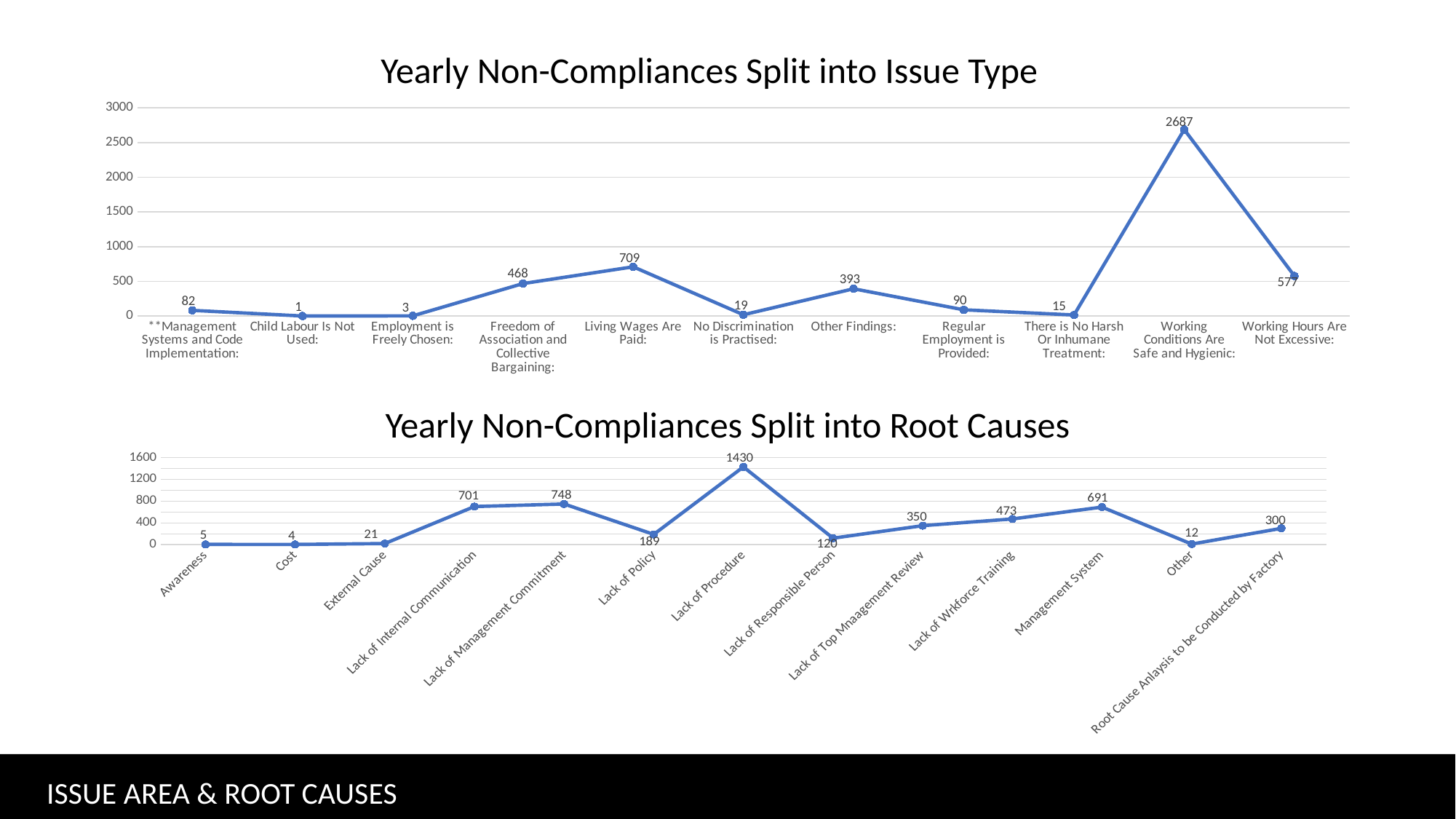
In the 'Yearly Non-Compliances Split into Issue Type' chart, how many issue types are plotted? 11 In the 'Yearly Non-Compliances Split into Issue Type' chart, which issue type has the highest value? Working Conditions Are Safe and Hygienic: In the 'Yearly Non-Compliances Split into Issue Type' chart, which issue type has the lowest value? Child Labour Is Not Used: In the 'Yearly Non-Compliances Split into Issue Type' chart, what is the value for 'Living Wages Are Paid:'? 709 In the 'Yearly Non-Compliances Split into Root Causes' chart, what is the value for 'Lack of Procedure'? 1430 In the 'Yearly Non-Compliances Split into Issue Type' chart, what is the difference between 'Working Conditions Are Safe and Hygienic:' and 'Working Hours Are Not Excessive:'? 2110 What type of chart is 'Yearly Non-Compliances Split into Issue Type'? Line chart In the 'Yearly Non-Compliances Split into Issue Type' chart, what is the value for 'Other Findings:'? 393 In the 'Yearly Non-Compliances Split into Root Causes' chart, which is larger: 'Lack of Internal Communication' or 'Lack of Management Commitment'? Lack of Management Commitment In the 'Yearly Non-Compliances Split into Root Causes' chart, what is the difference between 'Management System' and 'Lack of Wrkforce Training'? 218 In the 'Yearly Non-Compliances Split into Root Causes' chart, how many root causes are plotted? 13 In the 'Yearly Non-Compliances Split into Root Causes' chart, which root cause has the lowest value? Cost